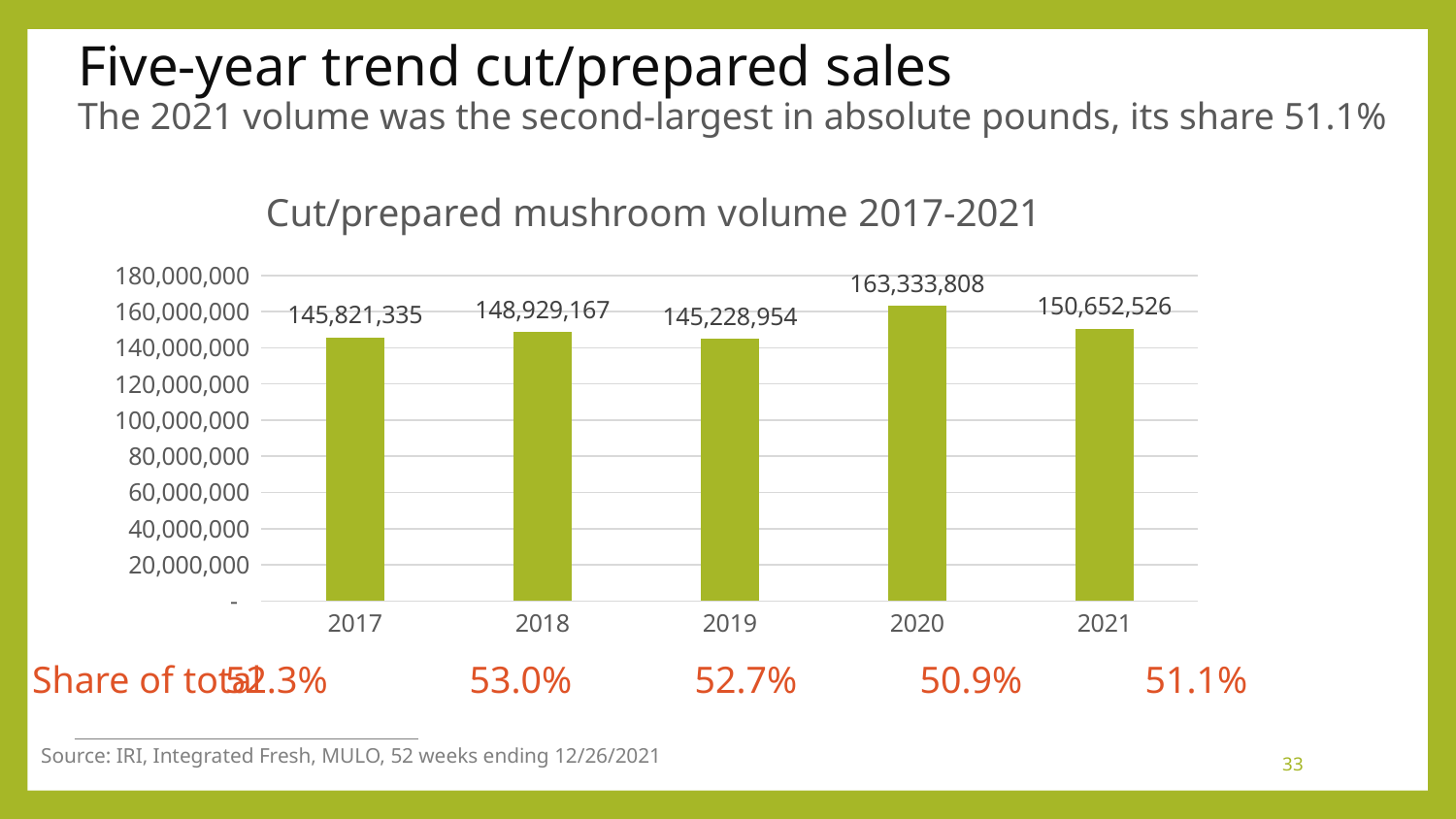
What is the cut/prepared mushroom volume for 2017? 145,821,335 Which year has the lowest cut/prepared mushroom volume? 2019 Is the value for 2020 greater or less than 160,000,000? greater Which year has the highest cut/prepared mushroom volume? 2020 Which year has the larger volume, 2018 or 2021? 2021 What is the cut/prepared mushroom volume for 2021? 150,652,526 How many years are plotted in the chart? 5 What is the difference in volume between 2020 and 2021? 12,681,282 What type of chart is shown on the slide? bar chart What is the title of the chart? Cut/prepared mushroom volume 2017-2021 Did the volume rise or fall from 2020 to 2021? fall What is the cut/prepared mushroom volume for 2020? 163,333,808